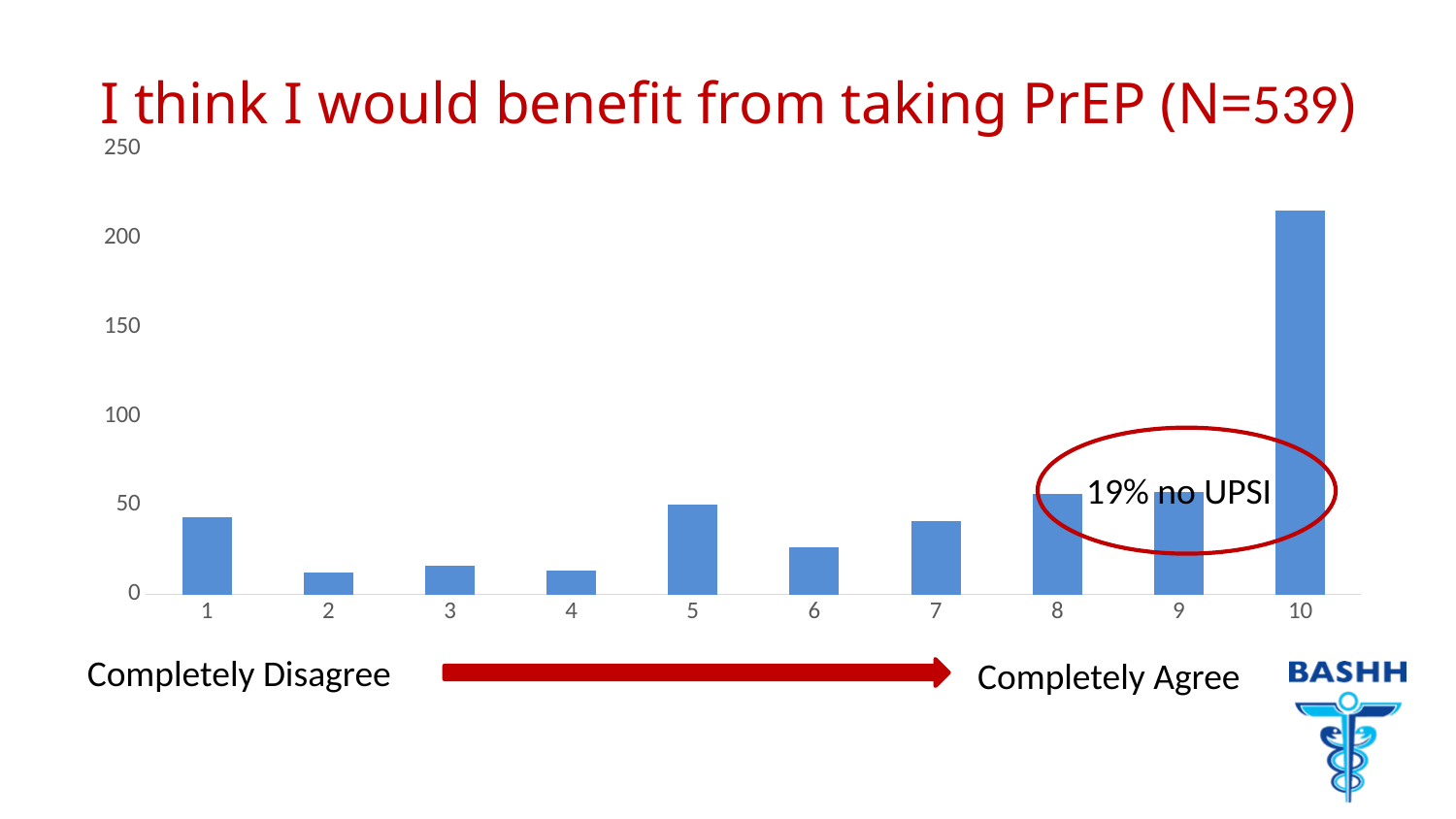
What text is written inside the red circle on the chart? 19% no UPSI Is the value for category 6 greater or less than 50? less Is the value for category 1 greater or less than 50? less What kind of chart is shown on the slide? bar chart How many categories are shown on the x axis of the chart? 10 Which category has the highest bar in the chart? 10 Which has a larger value, category 5 or category 2? 5 Is the value for category 10 greater or less than 200? greater What is the title of the chart? I think I would benefit from taking PrEP (N=539) Which has a larger value, category 10 or category 8? 10